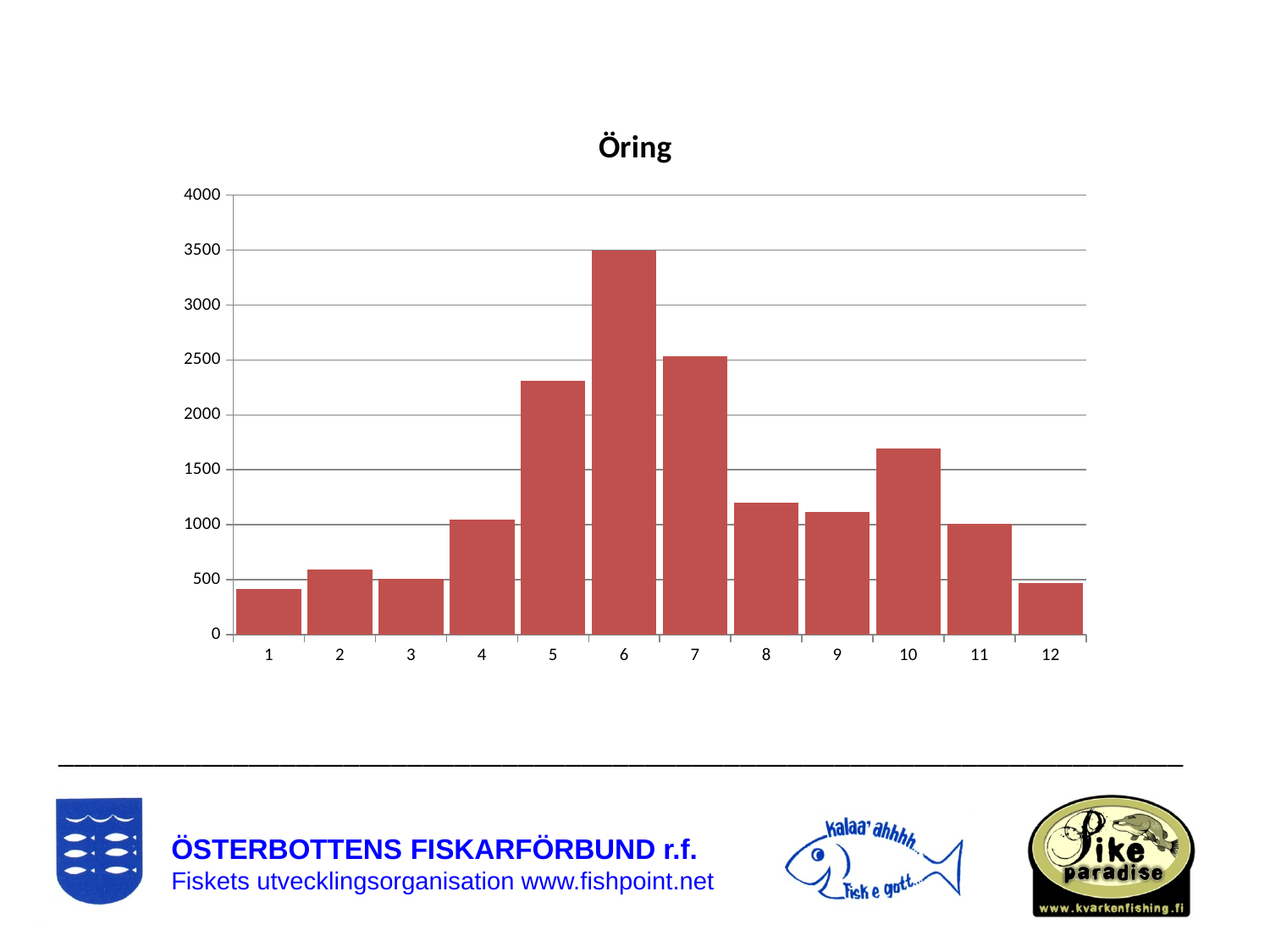
Which has the larger value, category 7 or category 8? 7 How many categories are shown on the x axis of the chart? 12 Is the value for category 1 greater or less than 500? less Do the values rise or fall from category 1 to category 6? rise Which category has the highest value in the chart? 6 Is the value for category 10 greater or less than 1500? greater What is the title of the chart? Öring Is the value for category 5 greater or less than 2500? less Which has the larger value, category 5 or category 10? 5 What kind of chart is shown on the slide? bar chart